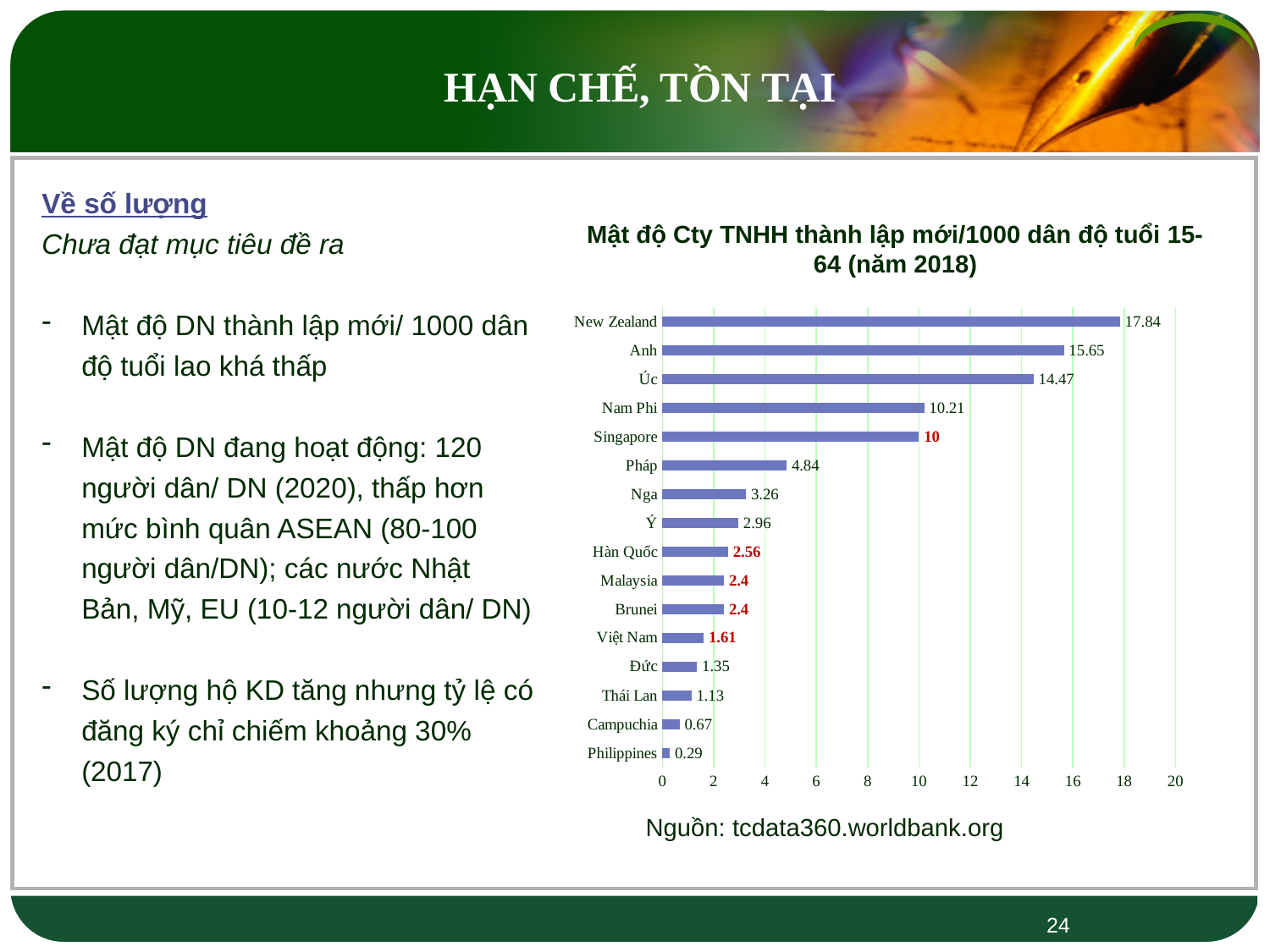
Which country has the highest value? New Zealand Which country has the lowest value? Philippines How many countries are shown in the chart? 16 What is the source cited below the chart? tcdata360.worldbank.org What is the difference between the values for New Zealand and Anh? 2.19 What is the value for Singapore? 10 What is the title of the chart? Mật độ Cty TNHH thành lập mới/1000 dân độ tuổi 15-64 (năm 2018) What kind of chart is shown on the slide? bar chart What is the value for Nam Phi? 10.21 Which is larger, the value for Pháp or the value for Nga? Pháp What is the value for Việt Nam? 1.61 Is the value for Úc greater or less than 14? greater